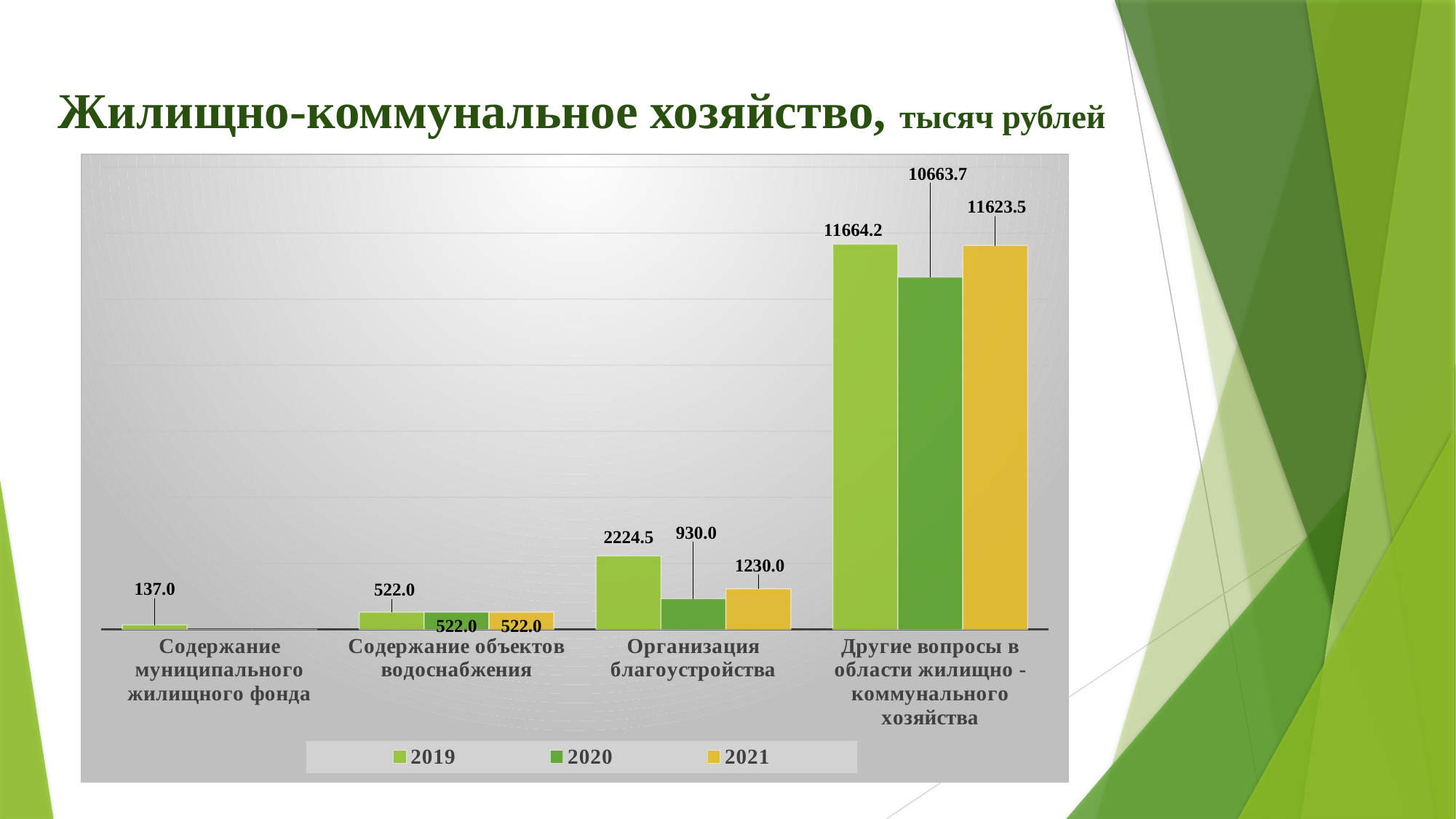
Which is larger for Другие вопросы в области жилищно-коммунального хозяйства: the 2019 value or the 2021 value? 2019 Which category has the highest 2021 value? Другие вопросы в области жилищно-коммунального хозяйства What unit is given in the chart title? тысяч рублей Which year has the lowest value for Организация благоустройства? 2020 What is the 2019 value for Организация благоустройства? 2224.5 What is the 2020 value for Другие вопросы в области жилищно-коммунального хозяйства? 10663.7 How many categories are shown on the x axis? 4 How many series does the legend list? 3 What is the 2019 value for Содержание муниципального жилищного фонда? 137.0 What is the 2021 value for Организация благоустройства? 1230.0 What type of chart is shown on the slide? bar chart What is the difference between the 2019 and 2020 values for Организация благоустройства? 1294.5